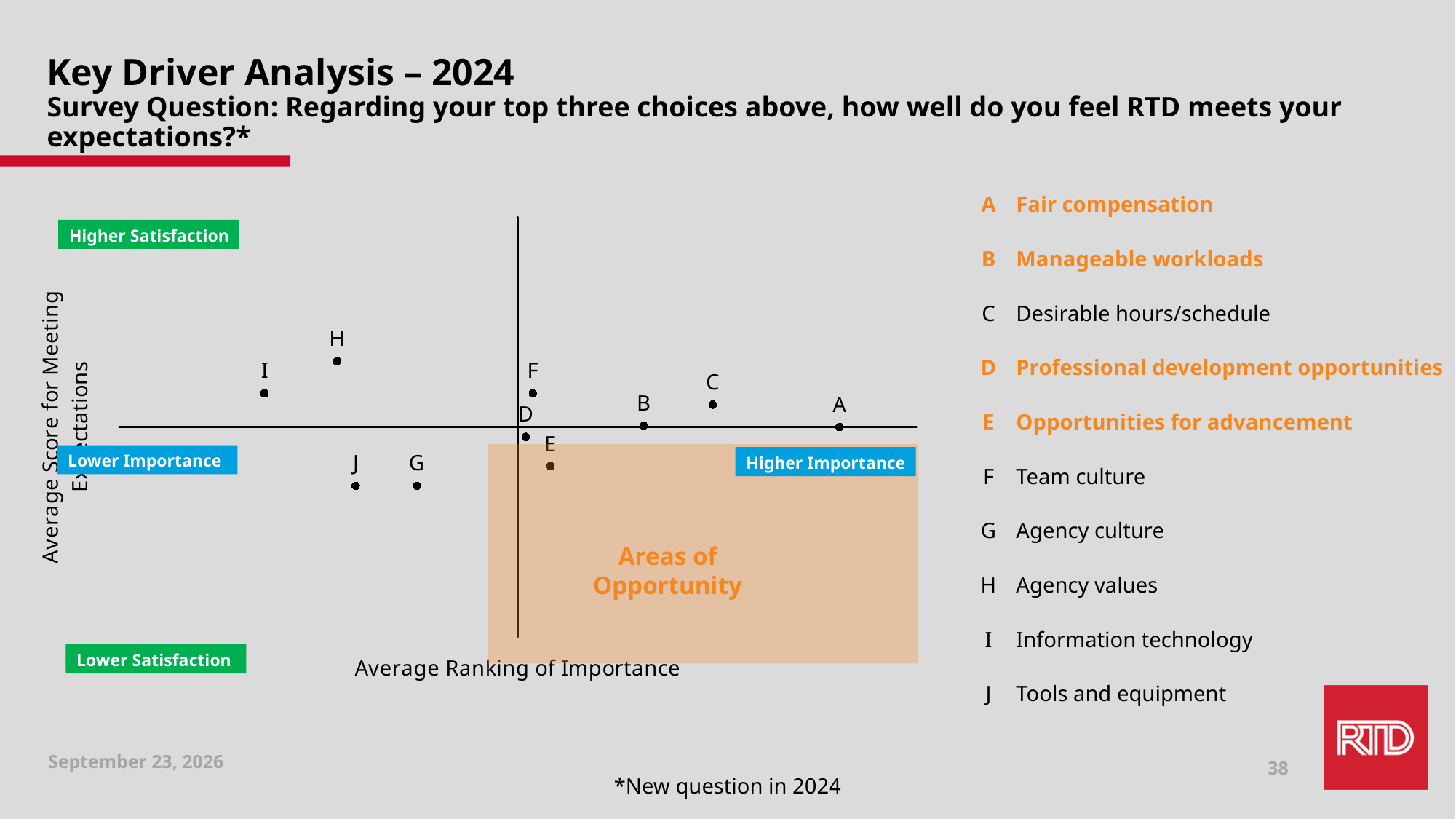
What does the label A on the chart stand for? Fair compensation How many labeled data points are plotted on the chart? 10 Which point has a higher Average Score for Meeting Expectations, F or E? F Which point ranks higher in importance (further right), A or C? A Which point has a higher Average Score for Meeting Expectations, H or I? H Which labeled point lies clearly inside the shaded 'Areas of Opportunity' region? E What kind of chart is shown on the slide? Scatter plot Which labeled point is furthest to the right on the Average Ranking of Importance axis? A What is the title of the horizontal axis? Average Ranking of Importance Which labeled point has the highest Average Score for Meeting Expectations? H Which labeled point is furthest to the left on the Average Ranking of Importance axis? I